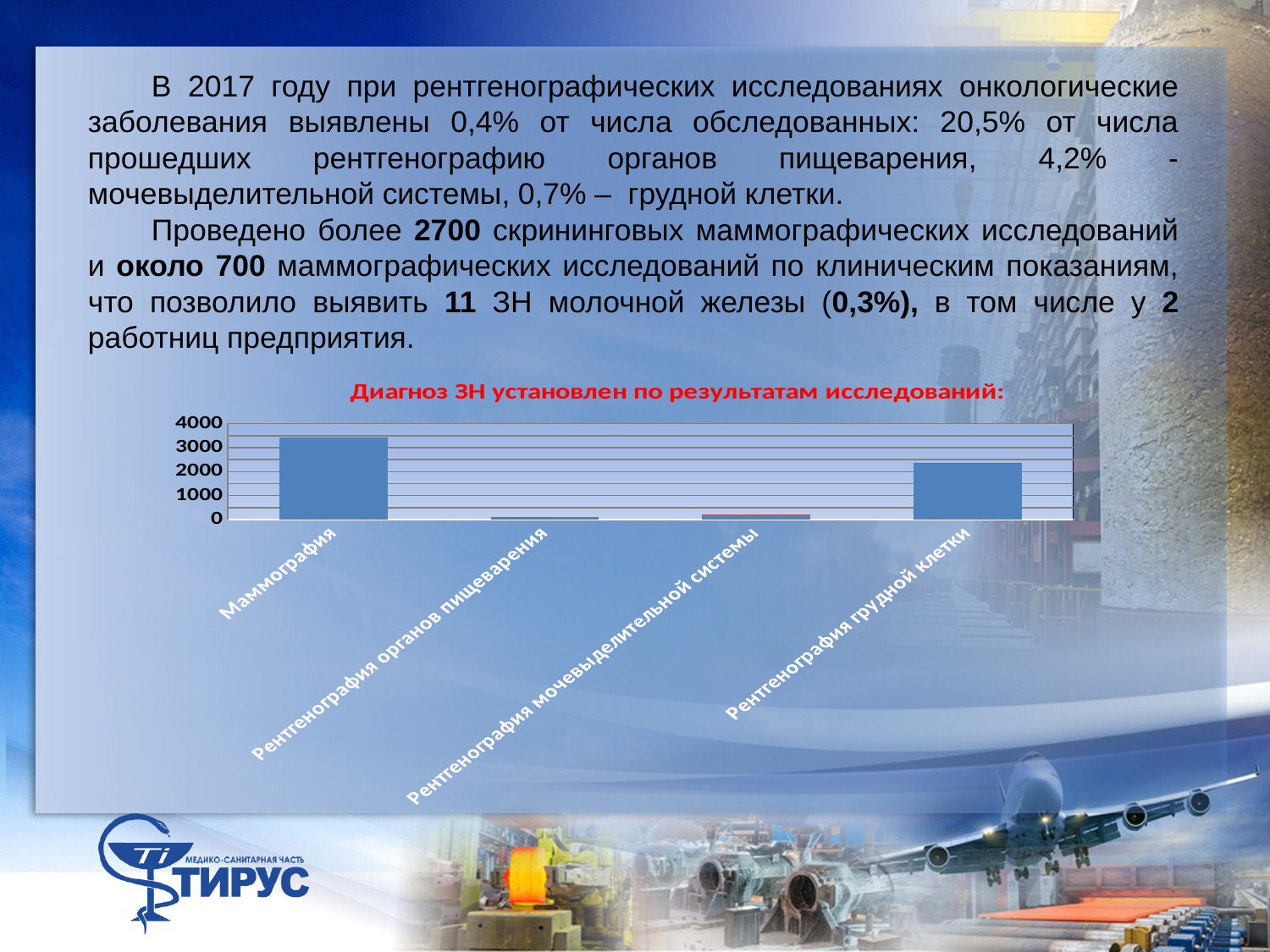
What is the title of the chart? Диагноз ЗН установлен по результатам исследований: Which is larger: the value for Маммография or the value for Рентгенография грудной клетки? Маммография Is the value for Рентгенография мочевыделительной системы greater or less than 1000? less Is the value for Рентгенография органов пищеварения greater or less than 1000? less Which category has the highest value in the chart? Маммография What kind of chart is shown on the slide? bar chart Is the value for Рентгенография грудной клетки greater or less than 3000? less What is the highest value shown on the chart's vertical axis? 4000 How many categories are plotted in the chart? 4 Which is larger: the value for Рентгенография грудной клетки or the value for Рентгенография органов пищеварения? Рентгенография грудной клетки